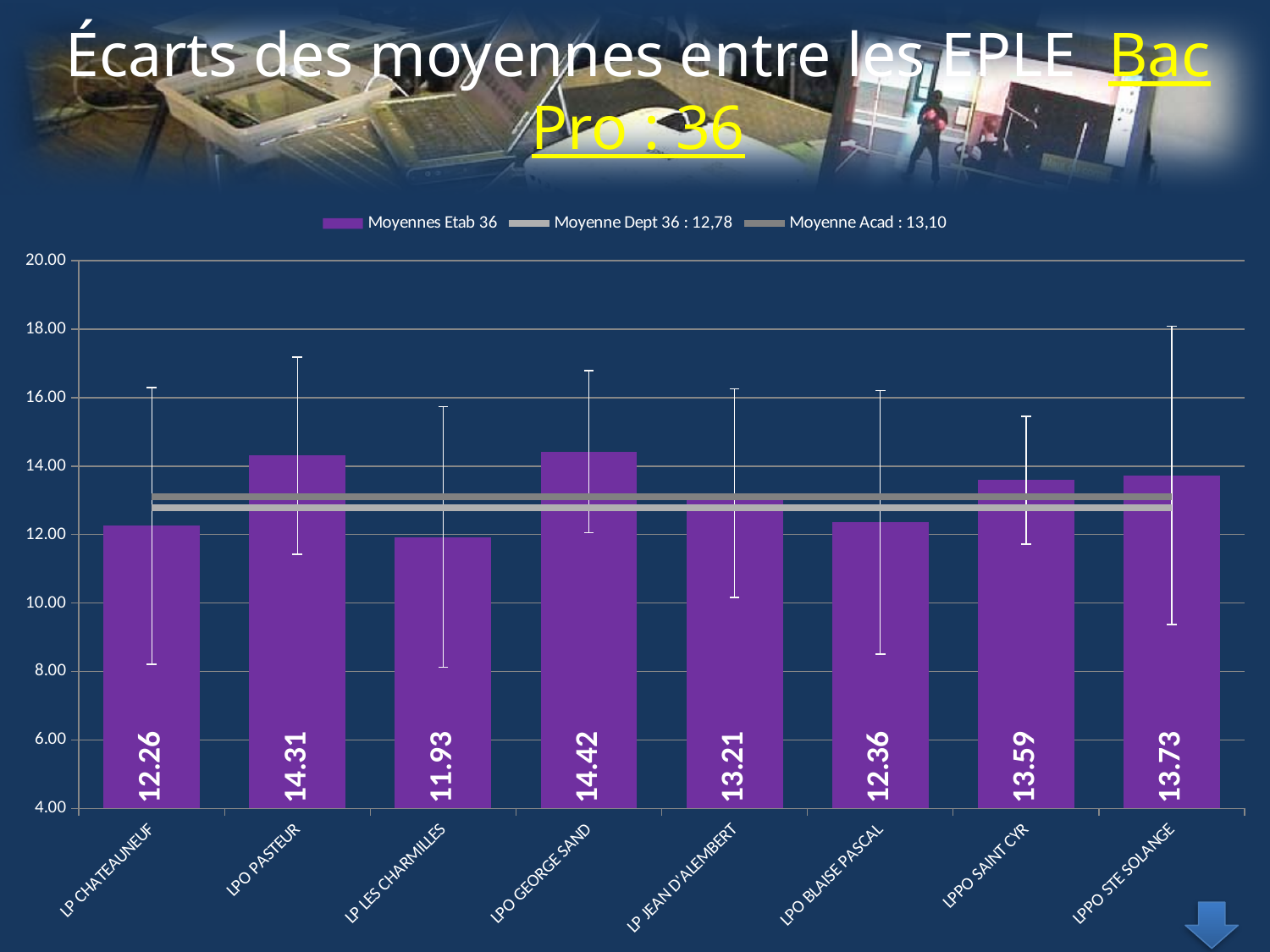
How many establishments are shown on the x axis? 8 What is the value for LPO PASTEUR? 14.31 What is the value for LPPO SAINT CYR? 13.59 What is the difference between the values for LPO PASTEUR and LP CHATEAUNEUF? 2.05 Is the value for LP LES CHARMILLES greater or less than 12.00? less Which establishment has the lowest value? LP LES CHARMILLES What is the difference between the values for LPO GEORGE SAND and LP LES CHARMILLES? 2.49 What kind of chart is shown on the slide? bar chart How many entries does the legend list? 3 Which is larger, the value for LPPO STE SOLANGE or the value for LPO BLAISE PASCAL? LPPO STE SOLANGE Which establishment has the highest value? LPO GEORGE SAND What is the value for LP JEAN D'ALEMBERT? 13.21